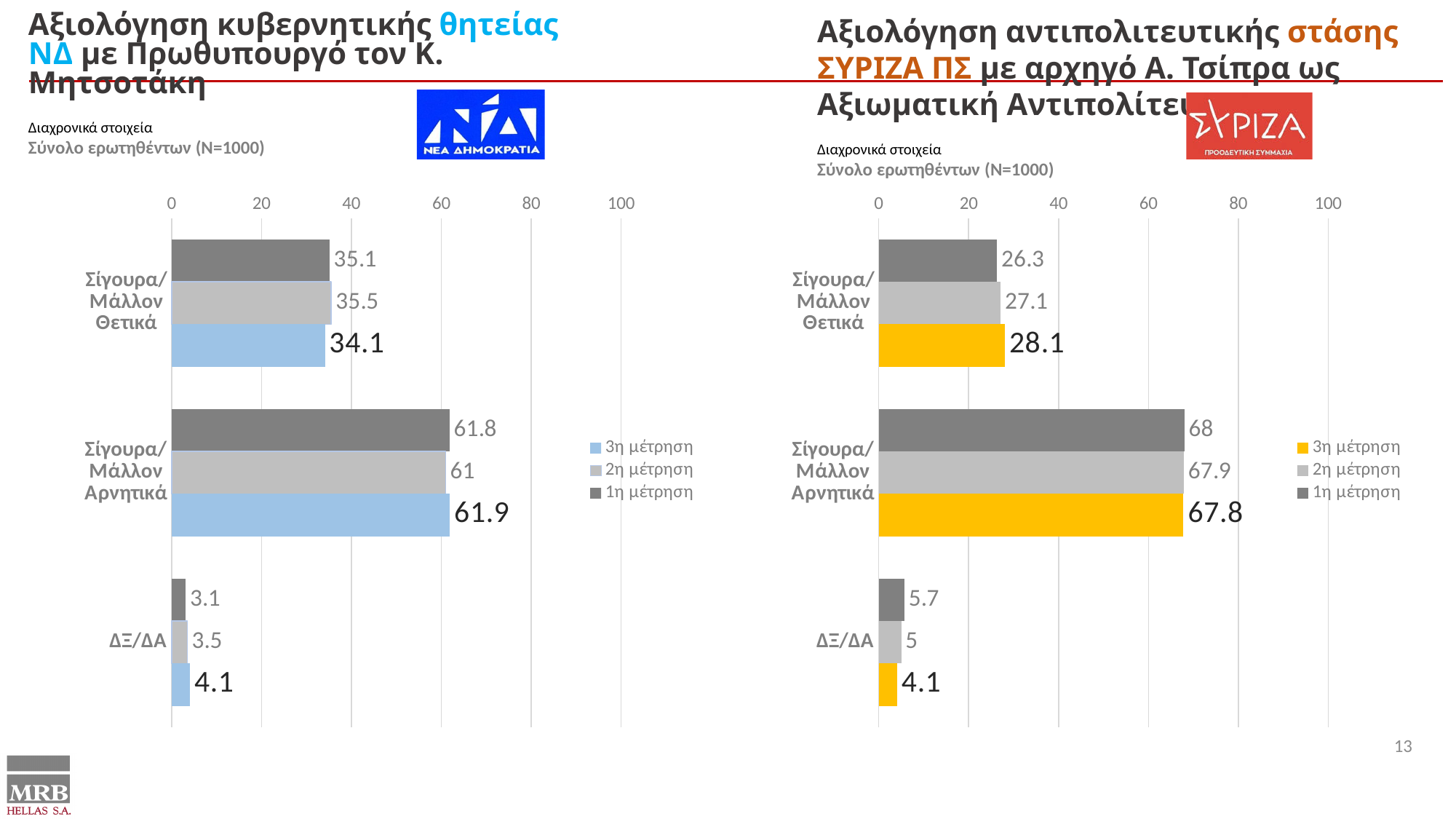
How many categories are shown in the right chart (ΣΥΡΙΖΑ ΠΣ)? 3 In the right chart (ΣΥΡΙΖΑ ΠΣ), what colour represents the 3η μέτρηση series? Yellow Comparing the 3η μέτρηση values for Σίγουρα/Μάλλον Θετικά, which chart shows the larger value, the left (ΝΔ) or the right (ΣΥΡΙΖΑ ΠΣ)? Left (ΝΔ) In the right chart (ΣΥΡΙΖΑ ΠΣ), what is the value for Σίγουρα/Μάλλον Αρνητικά in the 1η μέτρηση series? 68 How many series does the legend of the left chart (ΝΔ) list? 3 In the right chart (ΣΥΡΙΖΑ ΠΣ), which category has the lowest value in the 2η μέτρηση series? ΔΞ/ΔΑ In the left chart (ΝΔ), what is the difference between the 3η μέτρηση and 1η μέτρηση values for ΔΞ/ΔΑ? 1 In the right chart (ΣΥΡΙΖΑ ΠΣ), what is the difference between the 3η μέτρηση and 1η μέτρηση values for Σίγουρα/Μάλλον Θετικά? 1.8 What type of chart is the right chart (ΣΥΡΙΖΑ ΠΣ)? Bar chart In the left chart (ΝΔ), what is the value for Σίγουρα/Μάλλον Θετικά in the 3η μέτρηση series? 34.1 In the left chart (ΝΔ), which category has the highest value in the 3η μέτρηση series? Σίγουρα/Μάλλον Αρνητικά In the left chart (ΝΔ), is the 2η μέτρηση value for Σίγουρα/Μάλλον Αρνητικά greater or less than 60? greater